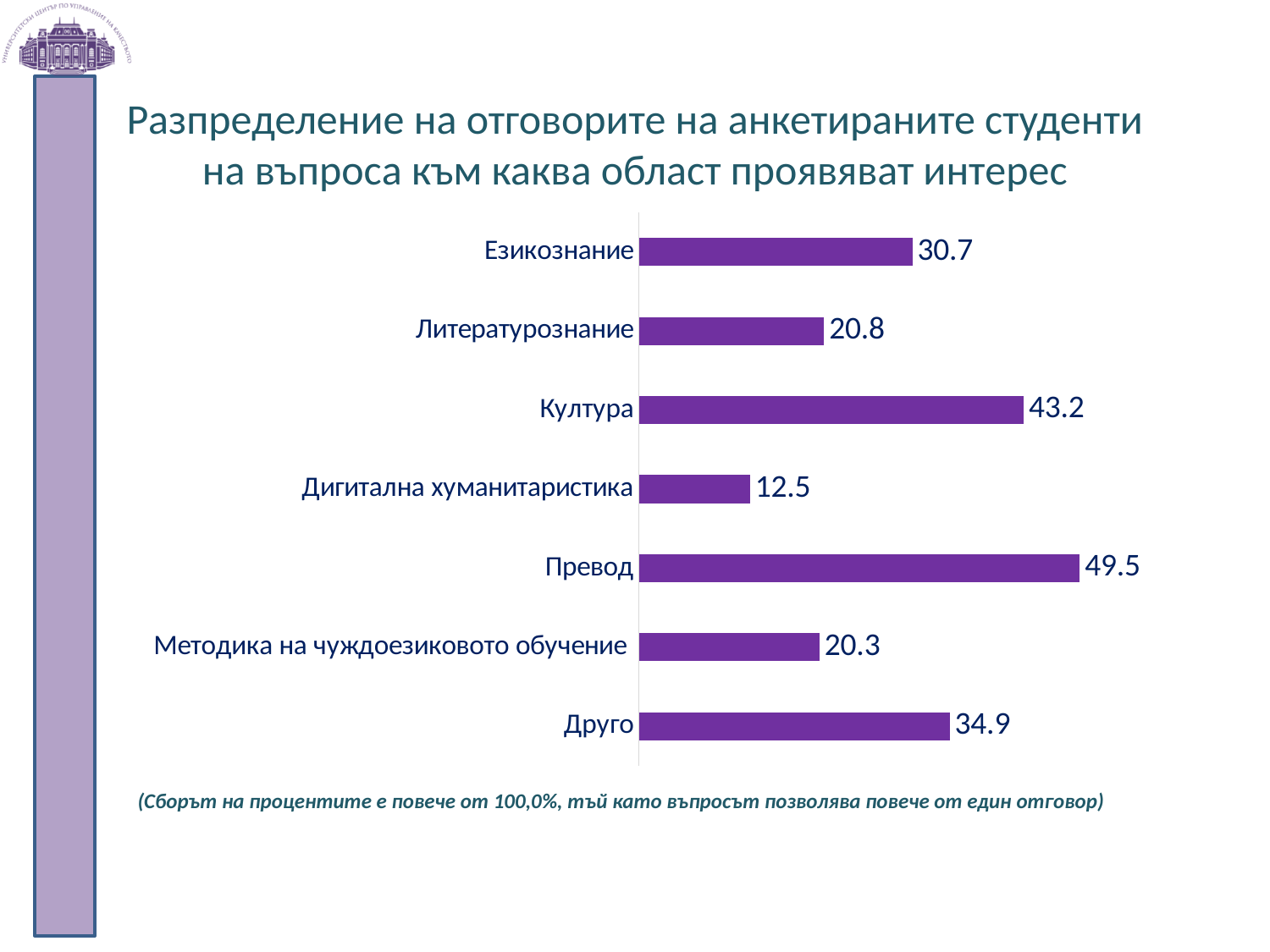
What kind of chart is shown on the slide? Bar chart What colour are the bars in the chart? Purple What is the value for Методика на чуждоезиковото обучение? 20.3 What is the difference between the values for Превод and Езикознание? 18.8 Which category has the highest value? Превод What is the value for Култура? 43.2 How many categories are shown in the chart? 7 Which category has the lowest value? Дигитална хуманитаристика What is the value for Превод? 49.5 What is the value for Дигитална хуманитаристика? 12.5 What is the difference between the values for Култура and Друго? 8.3 Which is larger, the value for Езикознание or the value for Друго? Друго